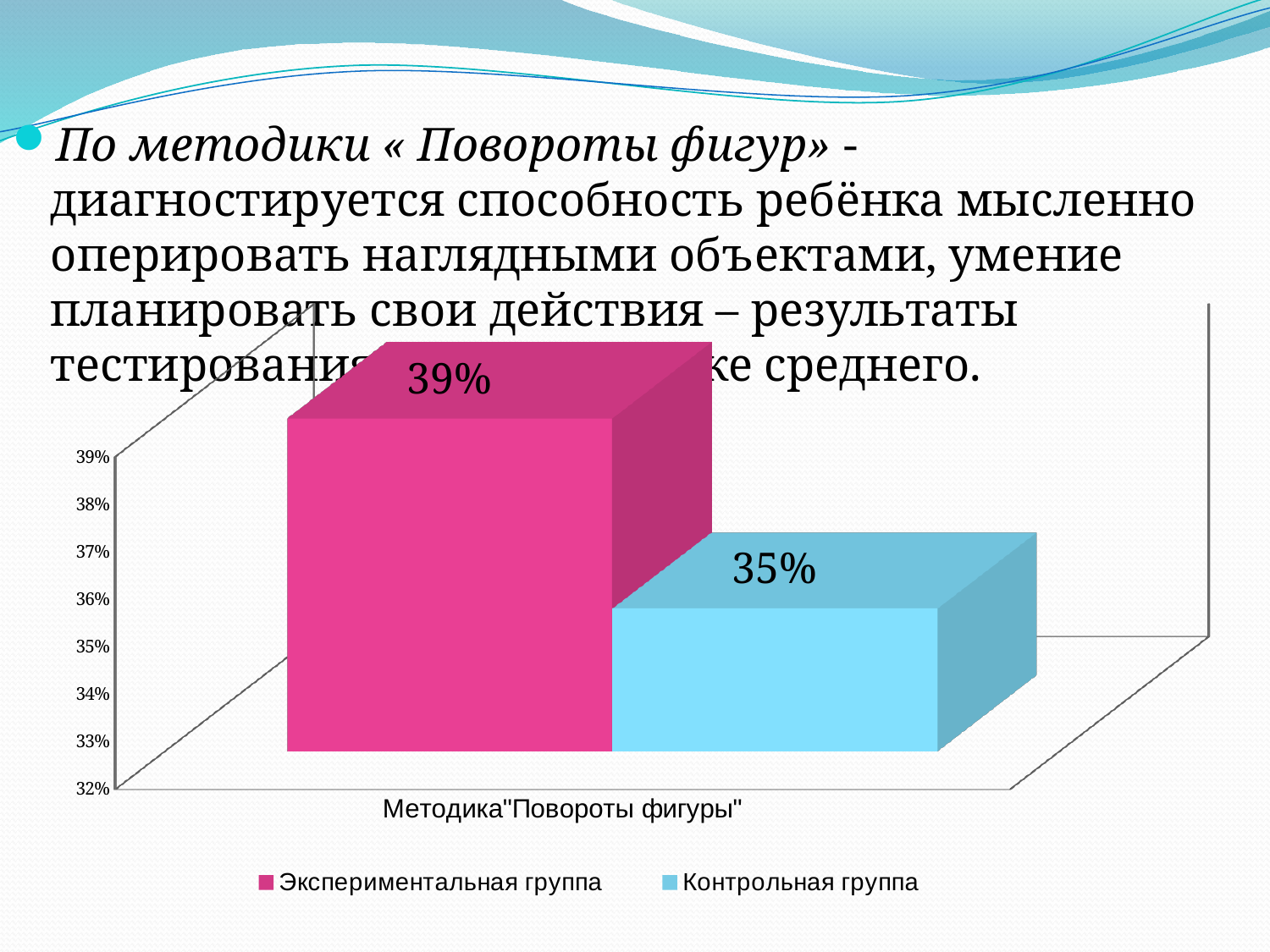
What is the value for Экспериментальная группа? 39% What colour is the bar for Контрольная группа? light blue Is the value for Экспериментальная группа larger or smaller than the value for Контрольная группа? larger How many series does the legend list? 2 Is the value for Контрольная группа greater or less than 36%? less Which group has the lower value? Контрольная группа What is the value for Контрольная группа? 35% What kind of chart is shown on the slide? bar chart What is the difference between the values for Экспериментальная группа and Контрольная группа? 4% How many categories are shown on the x axis? 1 What is the category label on the x axis? Методика"Повороты фигуры" Which group has the higher value? Экспериментальная группа